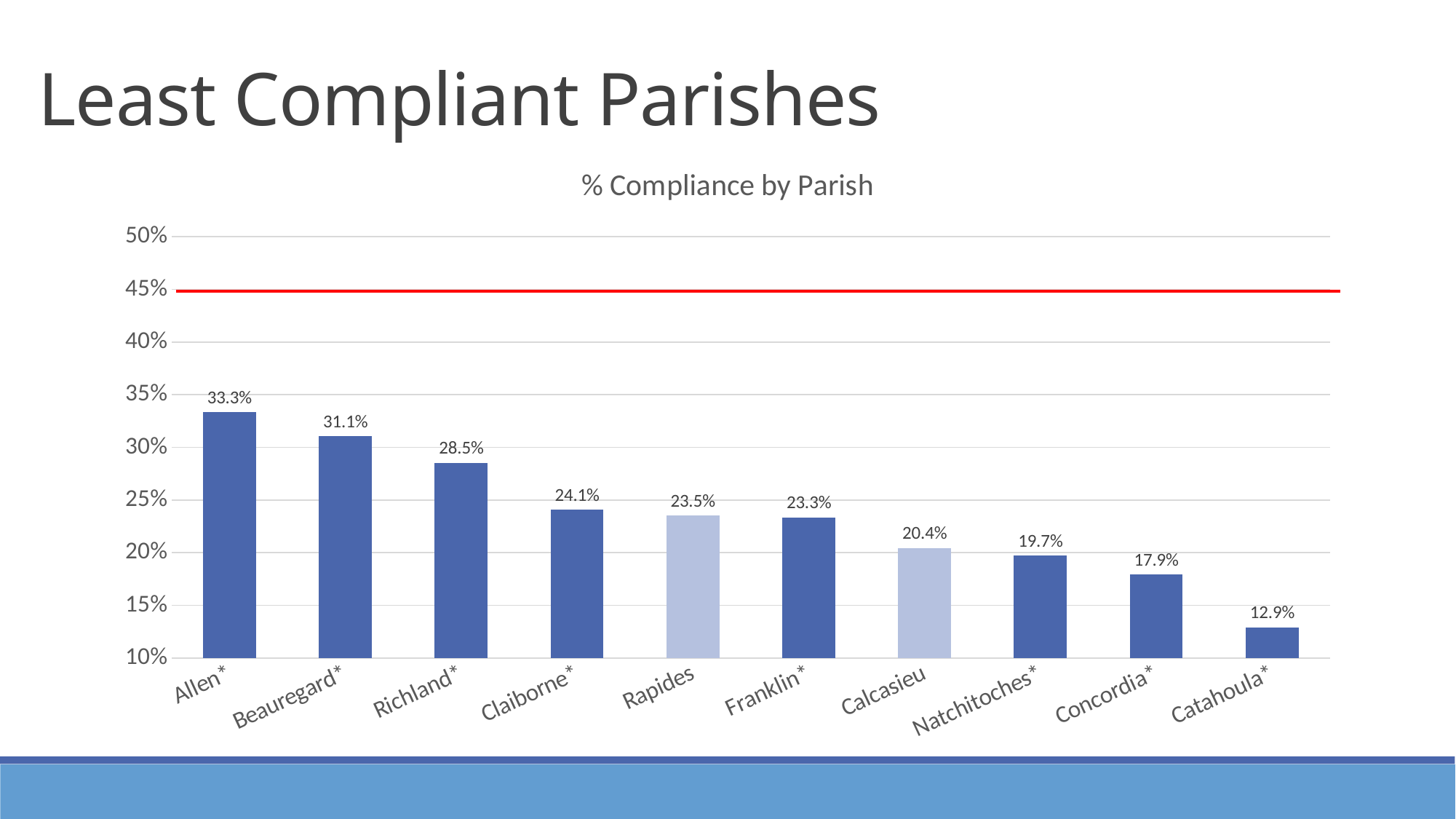
Do the values rise or fall from left to right across the parishes? Fall Which parish has the lowest compliance percentage? Catahoula* What kind of chart is shown on the slide? Bar chart What is the compliance percentage for Catahoula*? 12.9% Which has a higher compliance percentage, Richland* or Concordia*? Richland* What is the compliance percentage for Allen*? 33.3% What is the compliance percentage for Rapides? 23.5% What is the title of the chart? % Compliance by Parish Which parish has the highest compliance percentage? Allen* Is the value for Calcasieu greater or less than 25%? less How many parishes are shown in the chart? 10 What is the difference in compliance percentage between Allen* and Catahoula*? 20.4%